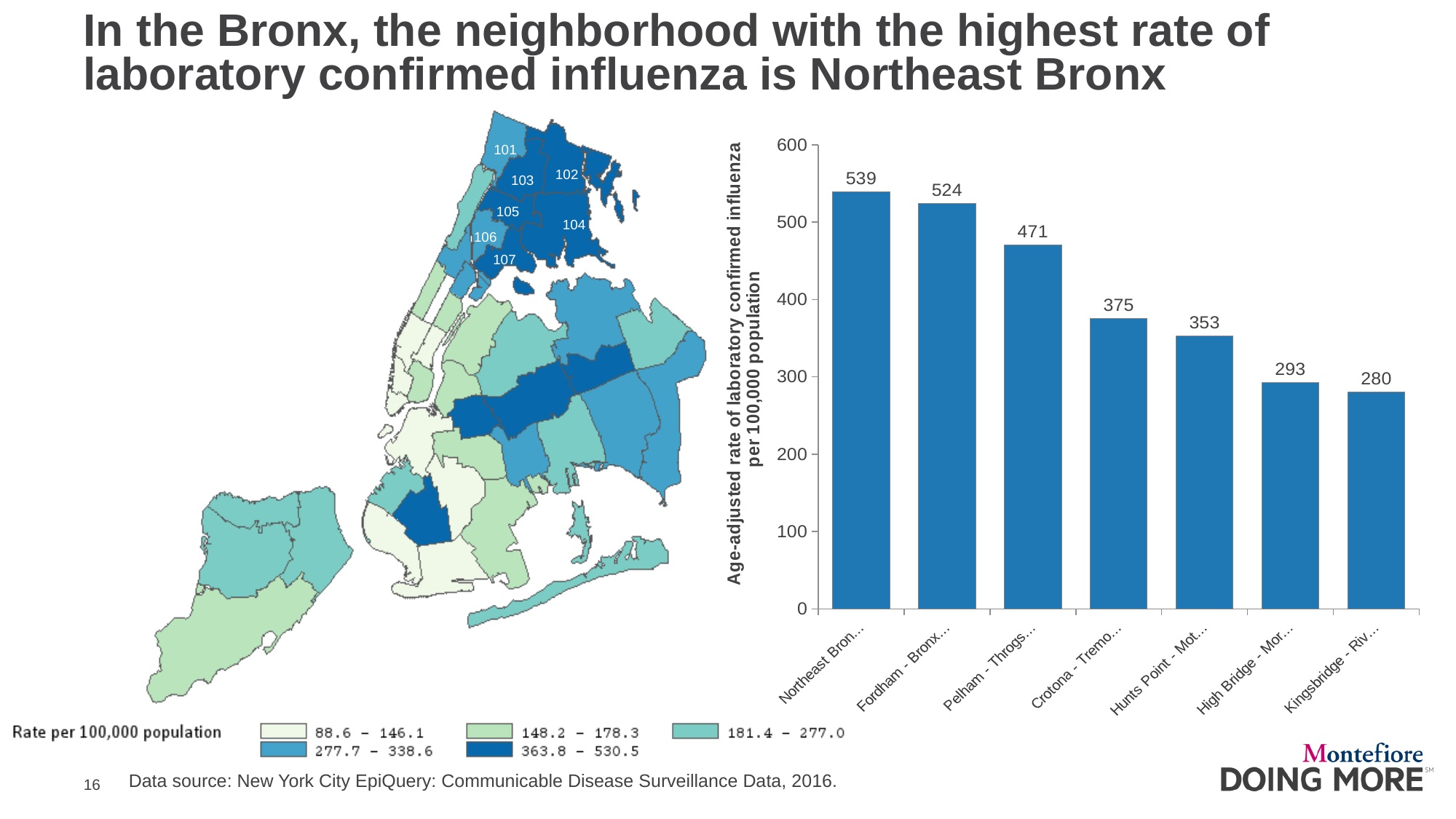
What kind of chart is shown on the right side of the slide? bar chart In the bar chart on the right, which neighborhood has the lowest rate? Kingsbridge - Riv... In the bar chart on the right, what is the difference between the rates for Northeast Bronx and Fordham - Bronx...? 15 In the bar chart on the right, which neighborhood has the highest age-adjusted rate of laboratory confirmed influenza? Northeast Bronx In the bar chart on the right, what is the rate for the Crotona - Tremo... neighborhood? 375 In the bar chart on the right, which has a higher rate: Hunts Point - Mot... or High Bridge - Mor...? Hunts Point - Mot... In the bar chart on the right, what is the rate for the Pelham - Throgs... neighborhood? 471 In the bar chart on the right, do the values rise or fall from left to right? fall How many neighborhoods are shown in the bar chart on the right? 7 In the bar chart on the right, how much higher is the rate for Crotona - Tremo... than for Hunts Point - Mot...? 22 In the bar chart on the right, what is the value of the highest bar? 539 What is the y-axis label of the bar chart on the right? Age-adjusted rate of laboratory confirmed influenza per 100,000 population